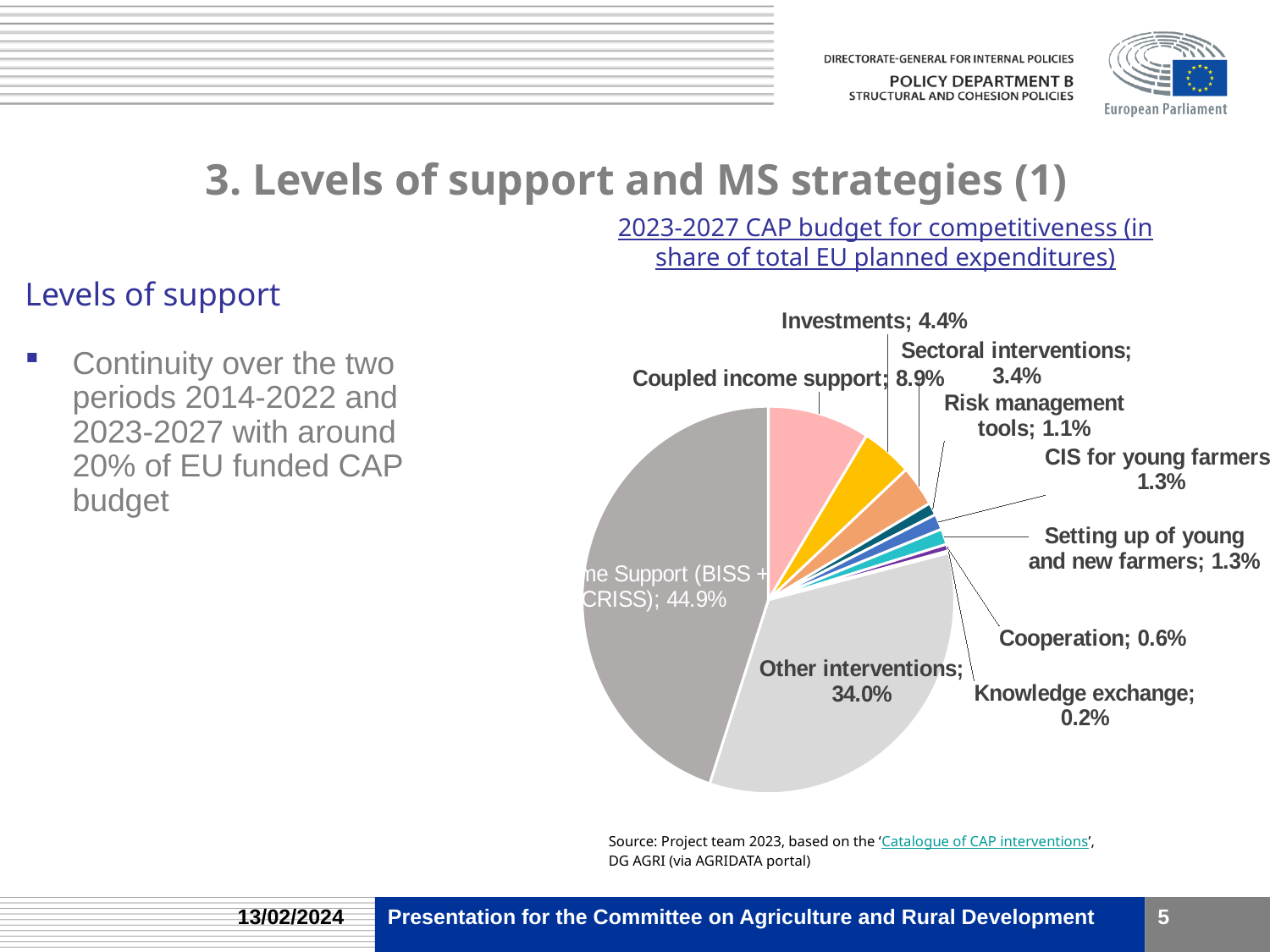
What type of chart is shown on the slide? Pie chart How many slices does the pie chart have? 10 What share is shown for Sectoral interventions? 3.4% What share is shown for Other interventions? 34.0% What share of the 2023-2027 CAP budget is labelled for Investments? 4.4% What is the difference in percentage points between Other interventions and Coupled income support? 25.1 percentage points Which slice of the pie chart has the largest share? Income Support (BISS + CRISS); 44.9% What share is shown for Coupled income support? 8.9% What share is shown for Risk management tools? 1.1% Which is larger, the share for Investments or the share for Sectoral interventions? Investments Which slice of the pie chart has the smallest share? Knowledge exchange; 0.2% What share is shown for Cooperation? 0.6%